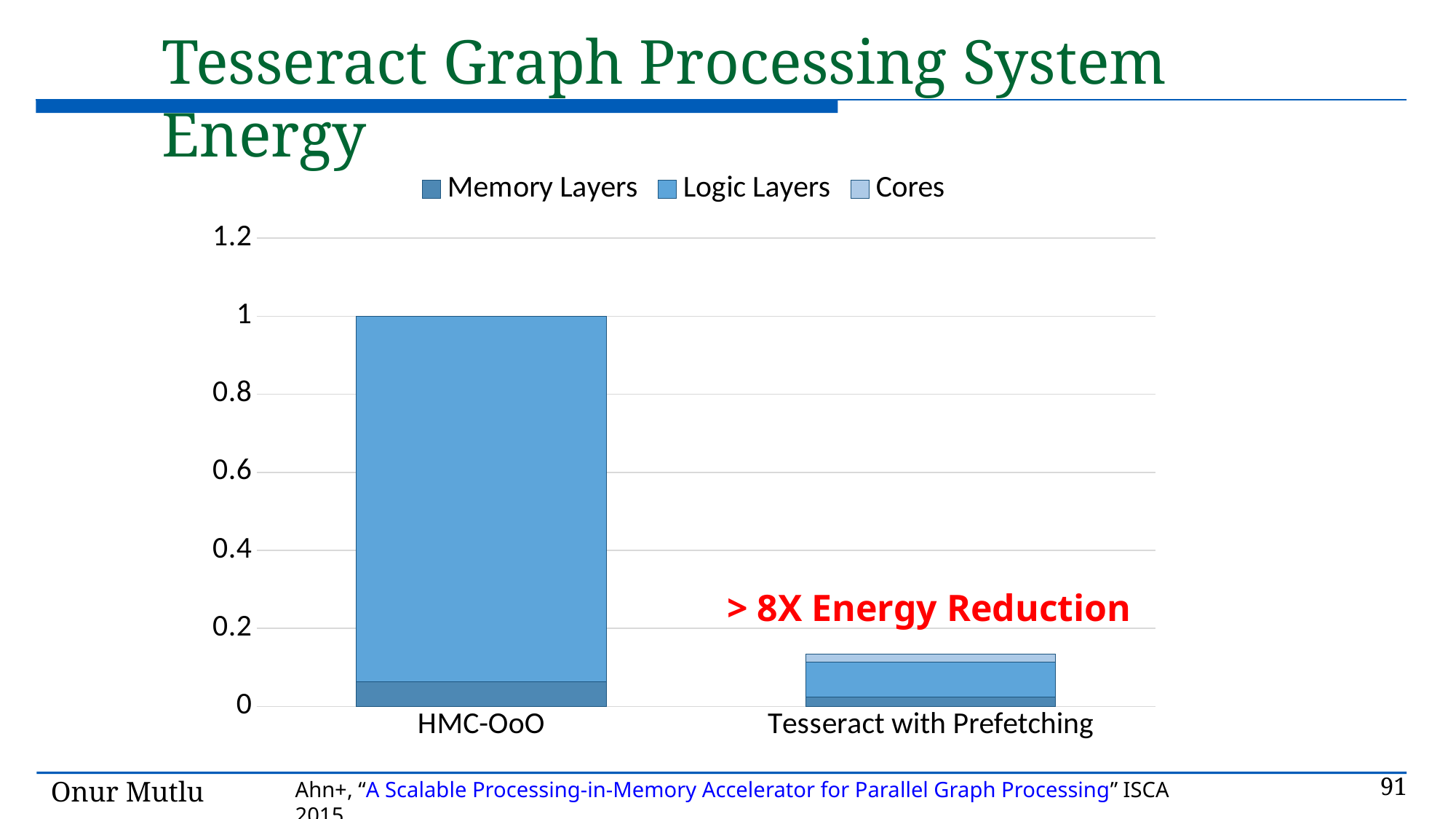
Is the total value for HMC-OoO greater or less than 0.8? greater What are the three series listed in the chart's legend? Memory Layers, Logic Layers, Cores What does the red annotation on the chart say? > 8X Energy Reduction What kind of chart is shown on the slide? stacked bar chart Which category has the lowest total energy in the chart? Tesseract with Prefetching How many categories are shown on the x axis of the chart? 2 Which has the larger total bar, HMC-OoO or Tesseract with Prefetching? HMC-OoO Which category has the highest total energy in the chart? HMC-OoO Is the total value for Tesseract with Prefetching greater or less than 0.2? less How many series does the chart's legend list? 3 What is the total height of the stacked bar for HMC-OoO? 1 Is the Memory Layers portion of the HMC-OoO bar greater or less than 0.2? less